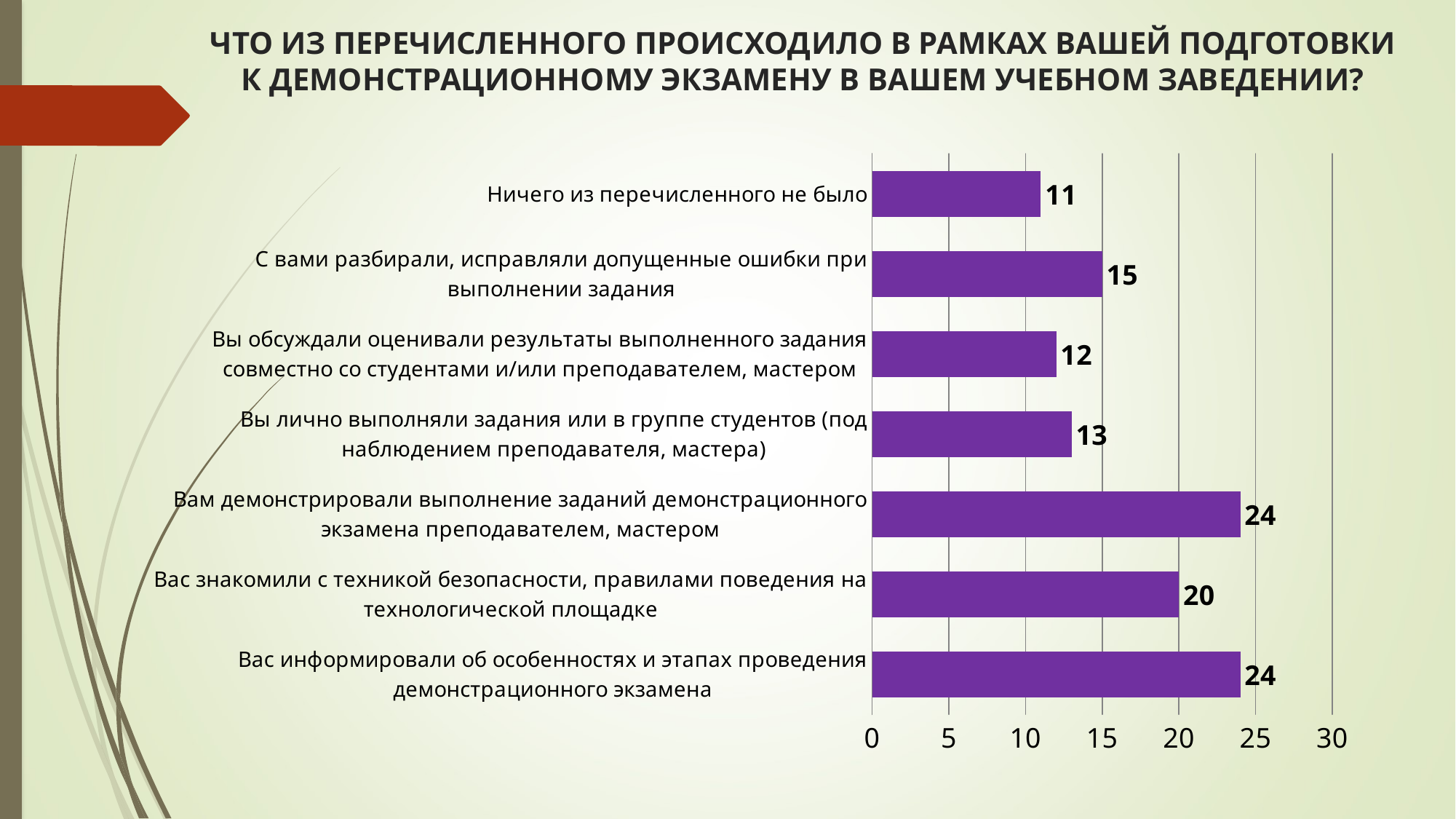
What is the value for "С вами разбирали, исправляли допущенные ошибки при выполнении задания"? 15 Which category has the lowest value? Ничего из перечисленного не было What is the value for "Вас знакомили с техникой безопасности, правилами поведения на технологической площадке"? 20 How many categories are plotted in the chart? 7 Is the value for "Вас информировали об особенностях и этапах проведения демонстрационного экзамена" greater or less than 20? greater What is the value for "Ничего из перечисленного не было"? 11 What colour are the bars in the chart? purple What type of chart is shown on the slide? bar chart Which is larger: the value for "С вами разбирали, исправляли допущенные ошибки при выполнении задания" or the value for "Вы обсуждали оценивали результаты выполненного задания совместно со студентами и/или преподавателем, мастером"? С вами разбирали, исправляли допущенные ошибки при выполнении задания What is the value for "Вы лично выполняли задания или в группе студентов (под наблюдением преподавателя, мастера)"? 13 What is the difference between the values for "Вам демонстрировали выполнение заданий демонстрационного экзамена преподавателем, мастером" and "Вас знакомили с техникой безопасности, правилами поведения на технологической площадке"? 4 What is the highest value shown in the chart? 24